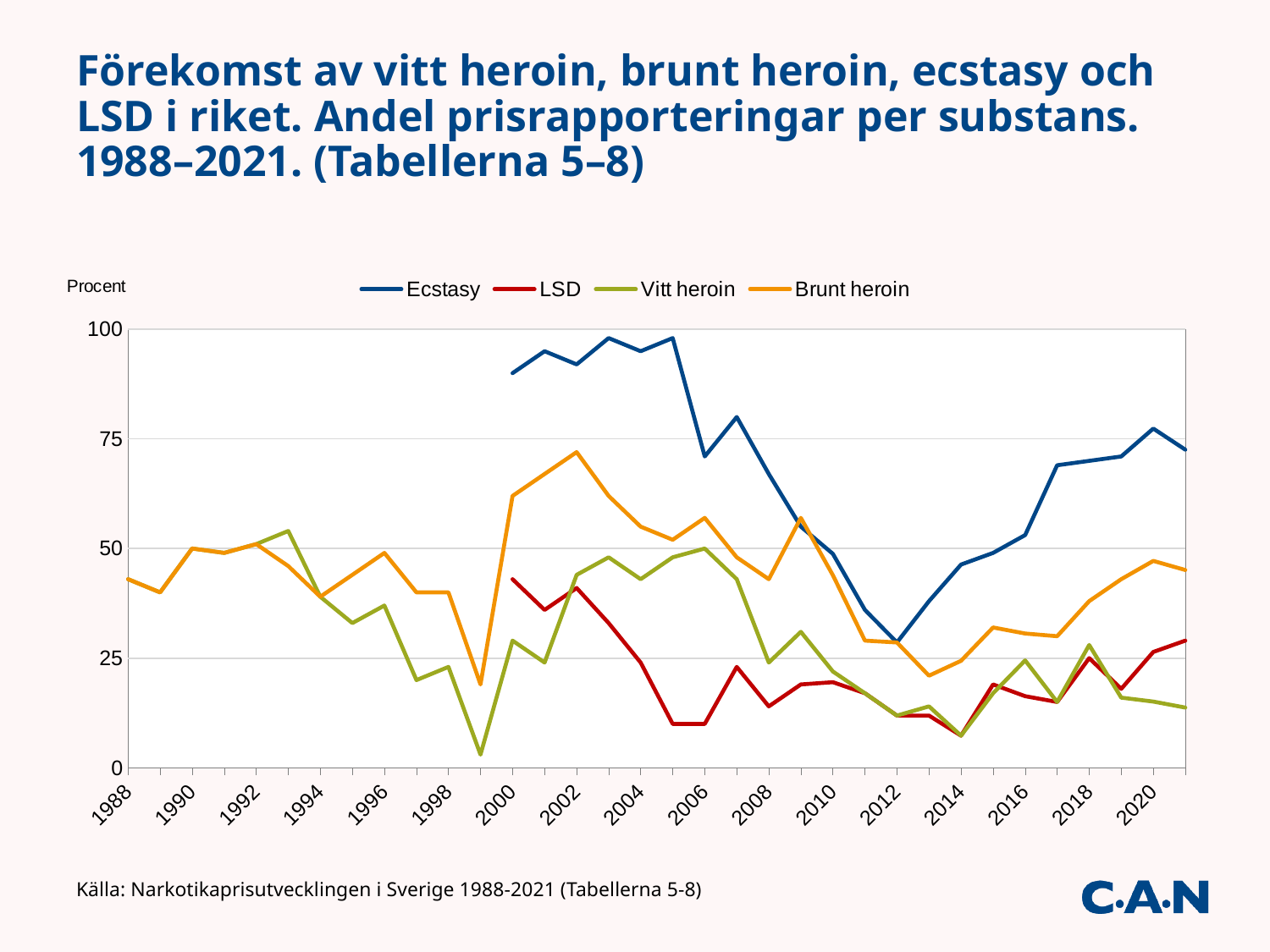
Is the value for Brunt heroin in 2002 greater or less than 50? greater Is the value for Ecstasy in 2005 greater or less than 75? greater Which series has the lowest value in 1999? Vitt heroin In 2021, which is larger: the value for Ecstasy or the value for Brunt heroin? Ecstasy How many series does the legend list? 4 Is the value for Vitt heroin in 1999 greater or less than 25? less What label is shown on the vertical axis? Procent Does the Ecstasy line rise or fall between 2005 and 2012? fall Which series has the highest value in 2005? Ecstasy What kind of chart is shown on the slide? line chart